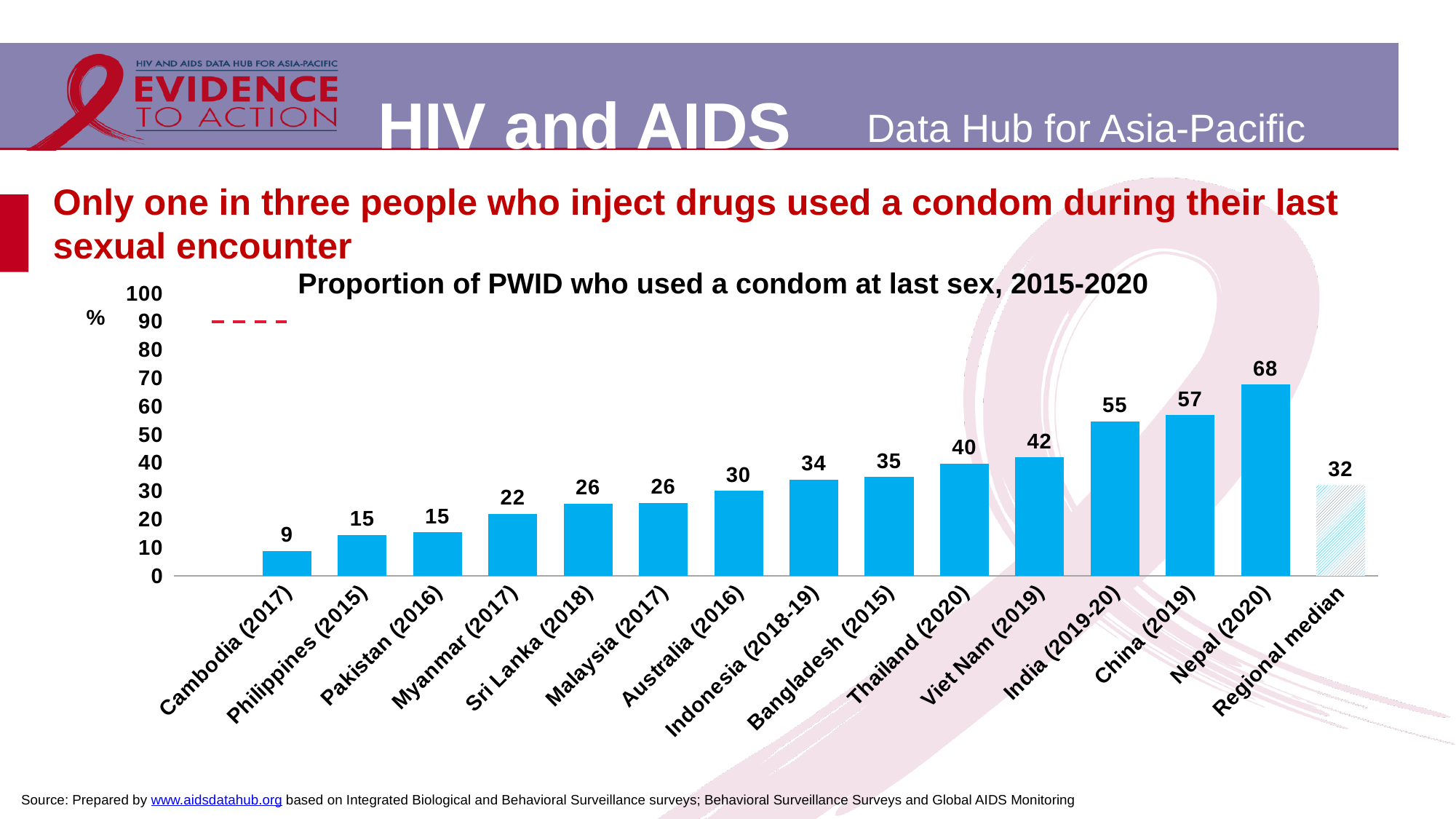
Which country has the highest proportion of PWID who used a condom at last sex? Nepal (2020) What is the value for Cambodia (2017)? 9 Which country has the lowest proportion of PWID who used a condom at last sex? Cambodia (2017) How many bars are plotted on the chart, including the Regional median? 15 Is the value for Viet Nam (2019) greater or less than 50? less What is the difference between the values for China (2019) and India (2019-20)? 2 Which is larger, the value for Thailand (2020) or the value for Bangladesh (2015)? Thailand (2020) What is the value for Nepal (2020)? 68 What is the title of the chart? Proportion of PWID who used a condom at last sex, 2015-2020 What is the Regional median value shown on the chart? 32 Do the country values rise or fall from left to right along the x axis? Rise What kind of chart is shown on the slide? Bar chart